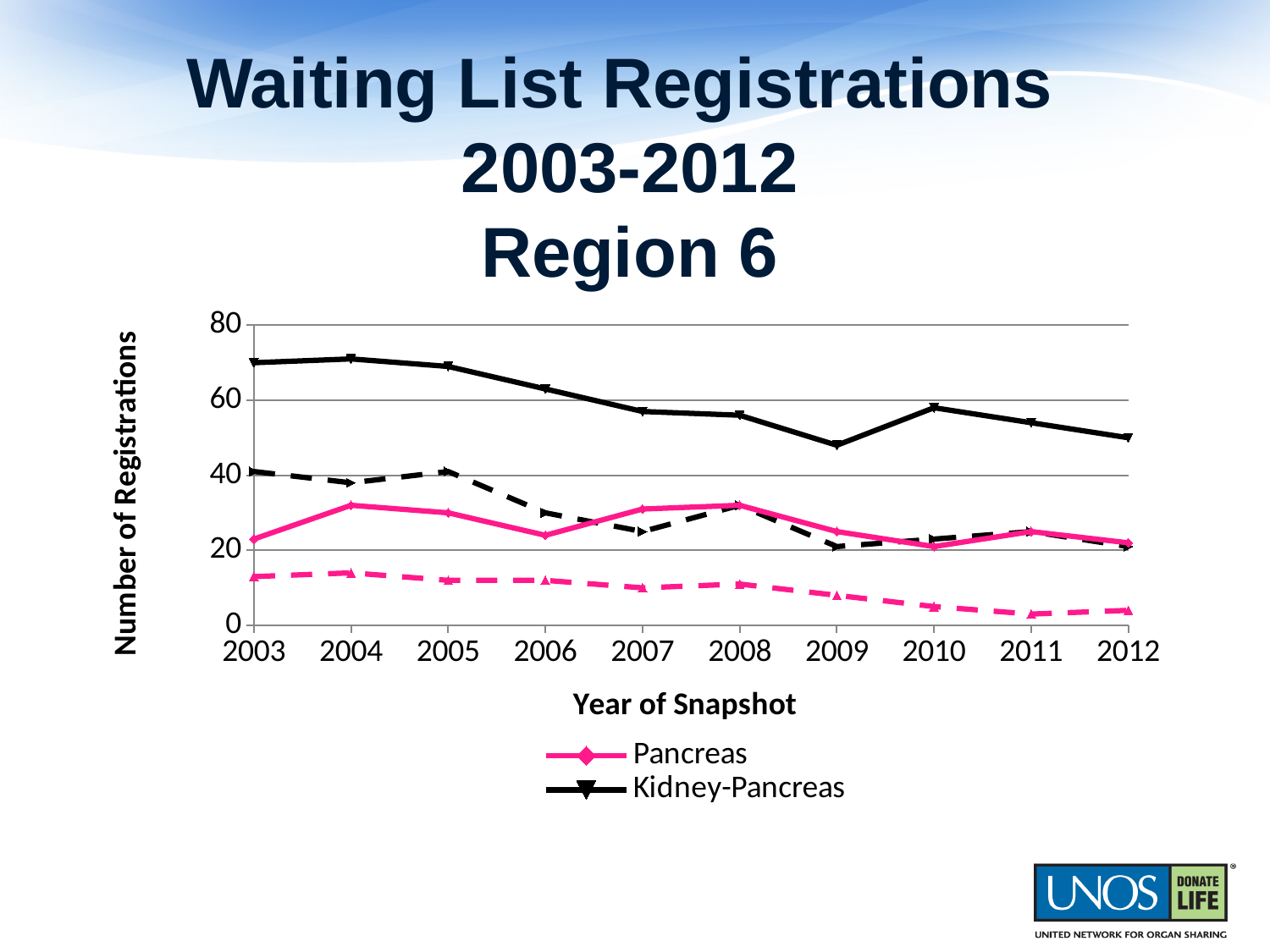
How many years are plotted along the x axis? 10 Is the Kidney-Pancreas value for 2009 greater or less than 60? less In 2003, which series has the higher value, Pancreas or Kidney-Pancreas? Kidney-Pancreas What kind of chart is shown on the slide? line chart For Kidney-Pancreas, is the value higher in 2003 or in 2012? 2003 What is the title of the y axis? Number of Registrations How many series does the legend list? 2 Is the Pancreas value for 2004 greater or less than 20? greater Is the Pancreas value for 2010 greater or less than 40? less Does the Kidney-Pancreas series overall rise or fall from 2003 to 2012? fall What is the title of the x axis? Year of Snapshot